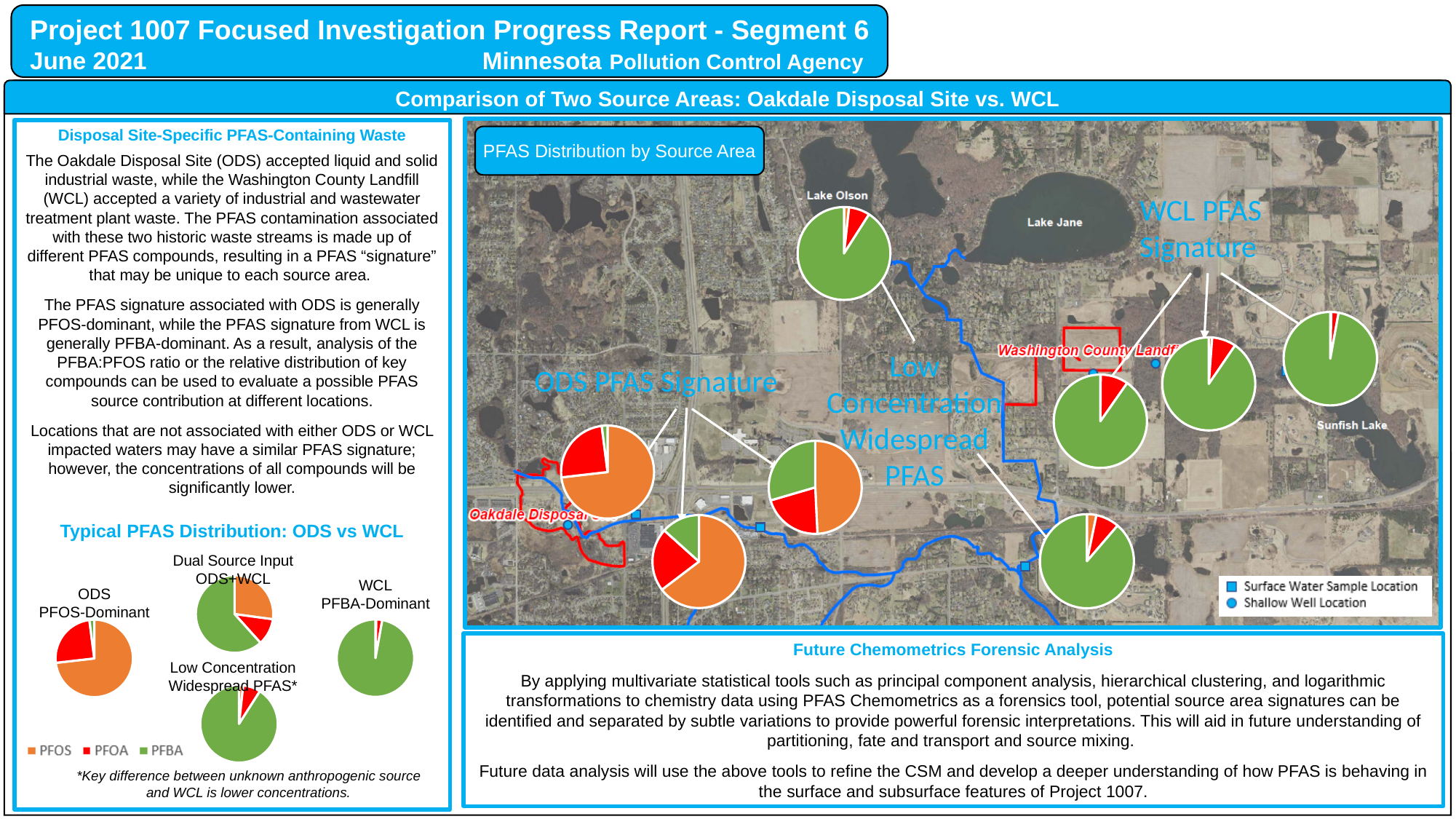
How many pie charts are shown in the 'Typical PFAS Distribution: ODS vs WCL' section? 4 In the 'Low Concentration Widespread PFAS*' pie chart, which compound has the largest slice? PFBA What are the legend entries for the 'Typical PFAS Distribution: ODS vs WCL' pie charts? PFOS, PFOA, PFBA In the 'ODS PFOS-Dominant' pie chart, which compound has the smallest slice? PFBA In the 'Dual Source Input ODS+WCL' pie chart, which slice is larger, PFOS or PFOA? PFOS In the 'ODS PFOS-Dominant' pie chart, which compound has the largest slice? PFOS In the 'WCL PFBA-Dominant' pie chart, which slice is larger, PFBA or PFOS? PFBA In the 'WCL PFBA-Dominant' pie chart, which compound has the largest slice? PFBA How many series does the legend of the 'Typical PFAS Distribution: ODS vs WCL' charts list? 3 What colour represents PFOA in the 'Typical PFAS Distribution: ODS vs WCL' pie charts? Red What kind of chart is used in the 'Typical PFAS Distribution: ODS vs WCL' section? Pie chart